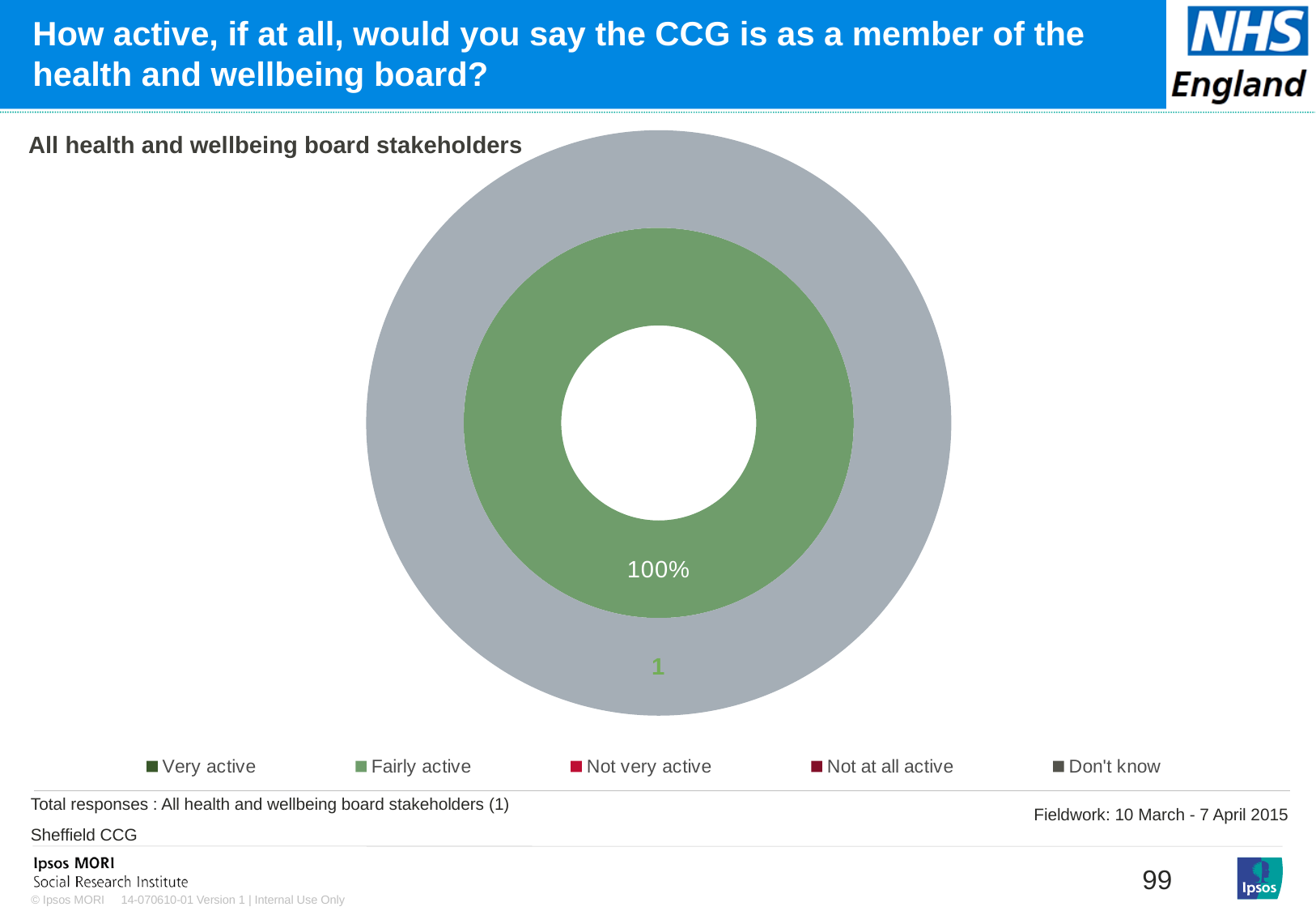
Which response category makes up the whole of the doughnut chart? Fairly active Is the value for Fairly active greater or less than 50%? greater How many response categories are visibly plotted with a data label in the doughnut chart? 1 What kind of chart is shown on the slide? doughnut chart What percentage is shown for Fairly active? 100% How many entries does the legend list? 5 What is the subtitle printed above the chart? All health and wellbeing board stakeholders What colour is the Fairly active segment in the chart? green What share of the doughnut does the Fairly active segment take up? 100%